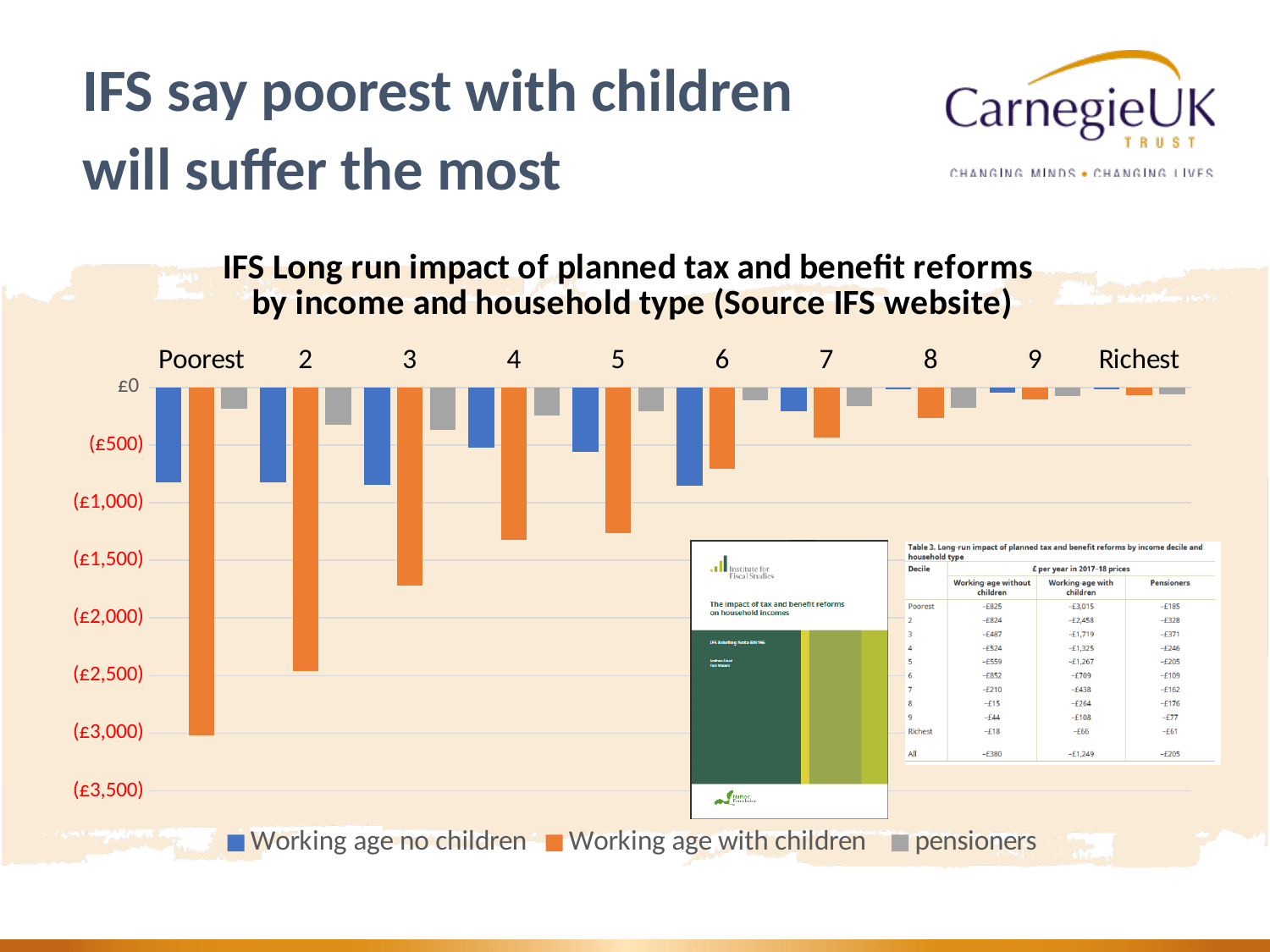
In the Poorest decile, which series shows the larger loss: Working age no children or Working age with children? Working age with children How many income deciles (categories) are shown on the x axis of the chart? 10 What kind of chart is shown on the slide? bar chart Is the value for Working age with children in the Poorest decile greater or less than (£2,500)? less Is the value for Working age no children in the Poorest decile greater or less than (£1,000)? greater In decile 6, which series shows the larger loss: Working age no children or Working age with children? Working age no children Moving from Poorest to Richest, do the losses for Working age with children get larger or smaller? smaller Which decile shows the largest loss for Working age with children? Poorest What colour represents Working age with children in the chart? orange How many series does the chart legend list? 3 Which decile shows the smallest loss for Working age with children? Richest Is the value for Working age with children in decile 3 greater or less than (£1,500)? less